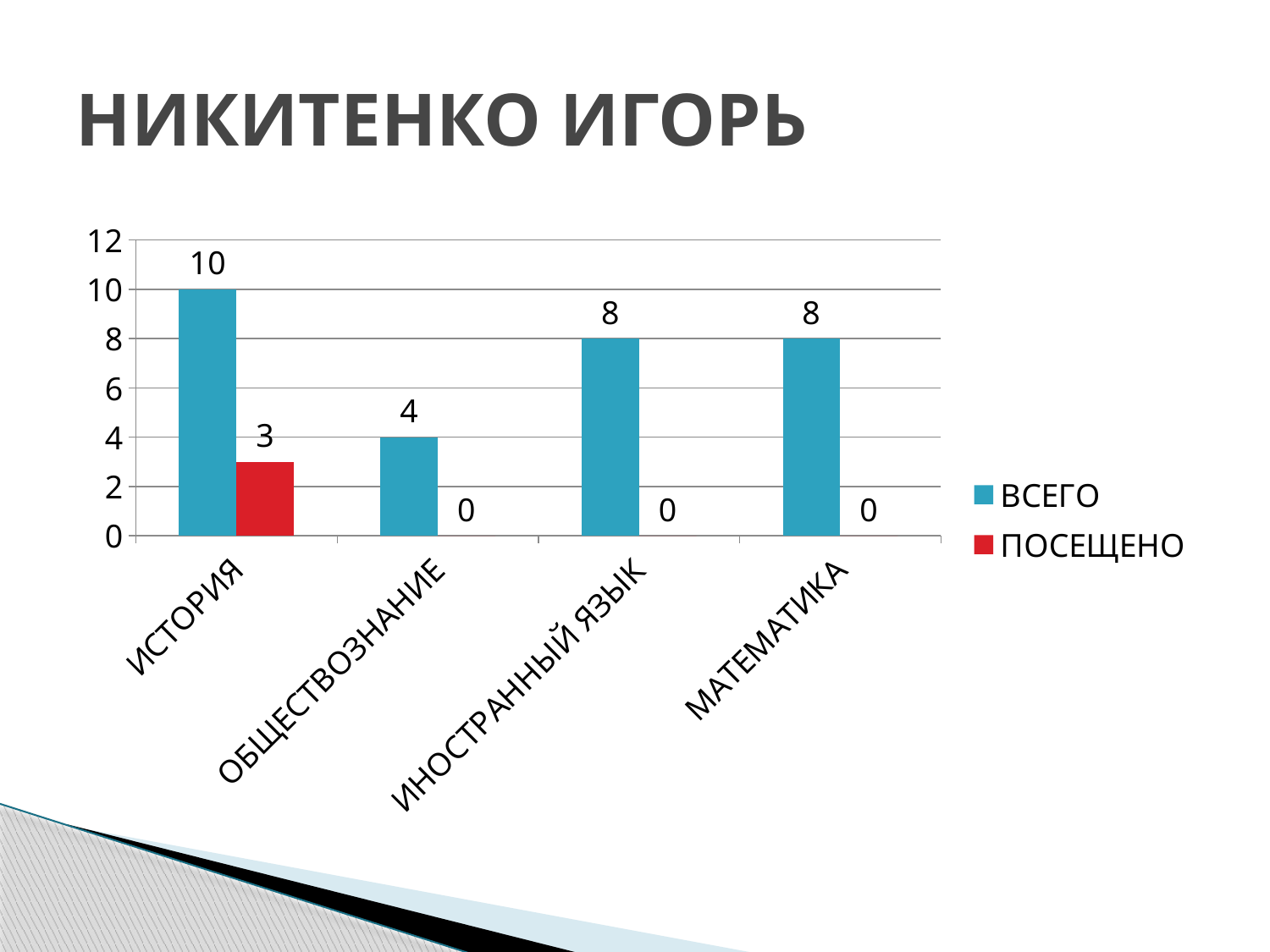
What is the ВСЕГО value for ОБЩЕСТВОЗНАНИЕ? 4 What is the ПОСЕЩЕНО value for МАТЕМАТИКА? 0 Which is larger: the ВСЕГО value for ИСТОРИЯ or the ВСЕГО value for ИНОСТРАННЫЙ ЯЗЫК? ИСТОРИЯ Which category has the lowest ВСЕГО value? ОБЩЕСТВОЗНАНИЕ What is the difference between the ВСЕГО and ПОСЕЩЕНО values for ИСТОРИЯ? 7 What kind of chart is shown on the slide? bar chart Which category has the highest ВСЕГО value? ИСТОРИЯ What is the ПОСЕЩЕНО value for ИСТОРИЯ? 3 What is the ВСЕГО value for ИСТОРИЯ? 10 What colour are the ПОСЕЩЕНО bars? red How many categories are shown on the x axis? 4 How many series does the legend list? 2